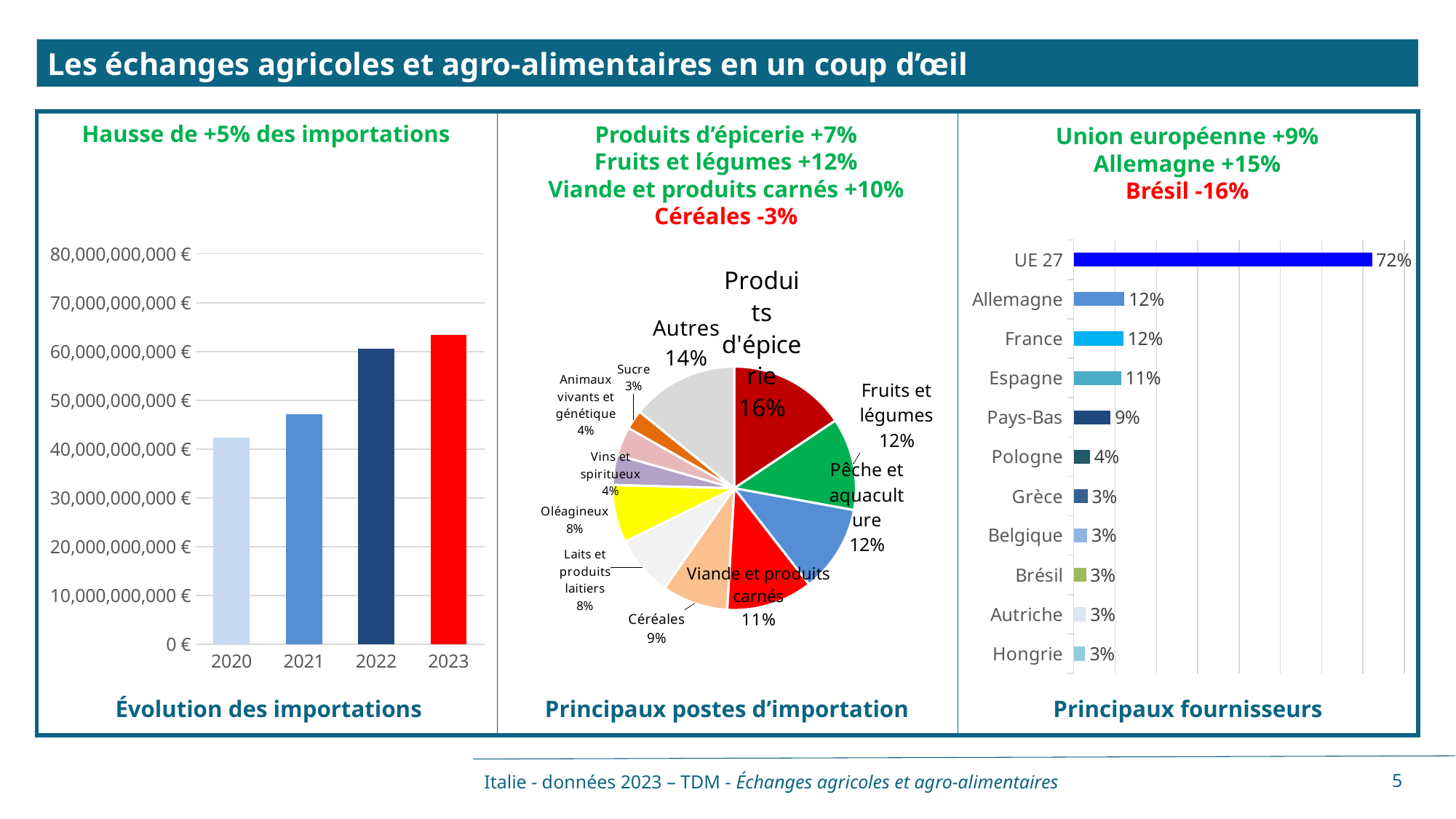
In the 'Principaux fournisseurs' chart, what is the value for Pays-Bas? 9% In the 'Principaux postes d'importation' pie chart, what share does Céréales have? 9% In the 'Évolution des importations' chart, what kind of chart is shown? bar chart In the 'Principaux postes d'importation' pie chart, which slice is the largest? Produits d'épicerie In the 'Évolution des importations' chart, which year has the highest value? 2023 In the 'Principaux postes d'importation' pie chart, how many slices are there? 11 In the 'Évolution des importations' chart, do the values rise or fall from 2020 to 2023? rise In the 'Principaux postes d'importation' pie chart, which slice is the smallest? Sucre In the 'Principaux fournisseurs' chart, what is the difference between UE 27 and Allemagne? 60 percentage points In the 'Évolution des importations' chart, how many years are plotted? 4 In the 'Évolution des importations' chart, is the value for 2021 greater or less than 50,000,000,000 €? less In the 'Principaux fournisseurs' chart, which is larger, Espagne or Pologne? Espagne